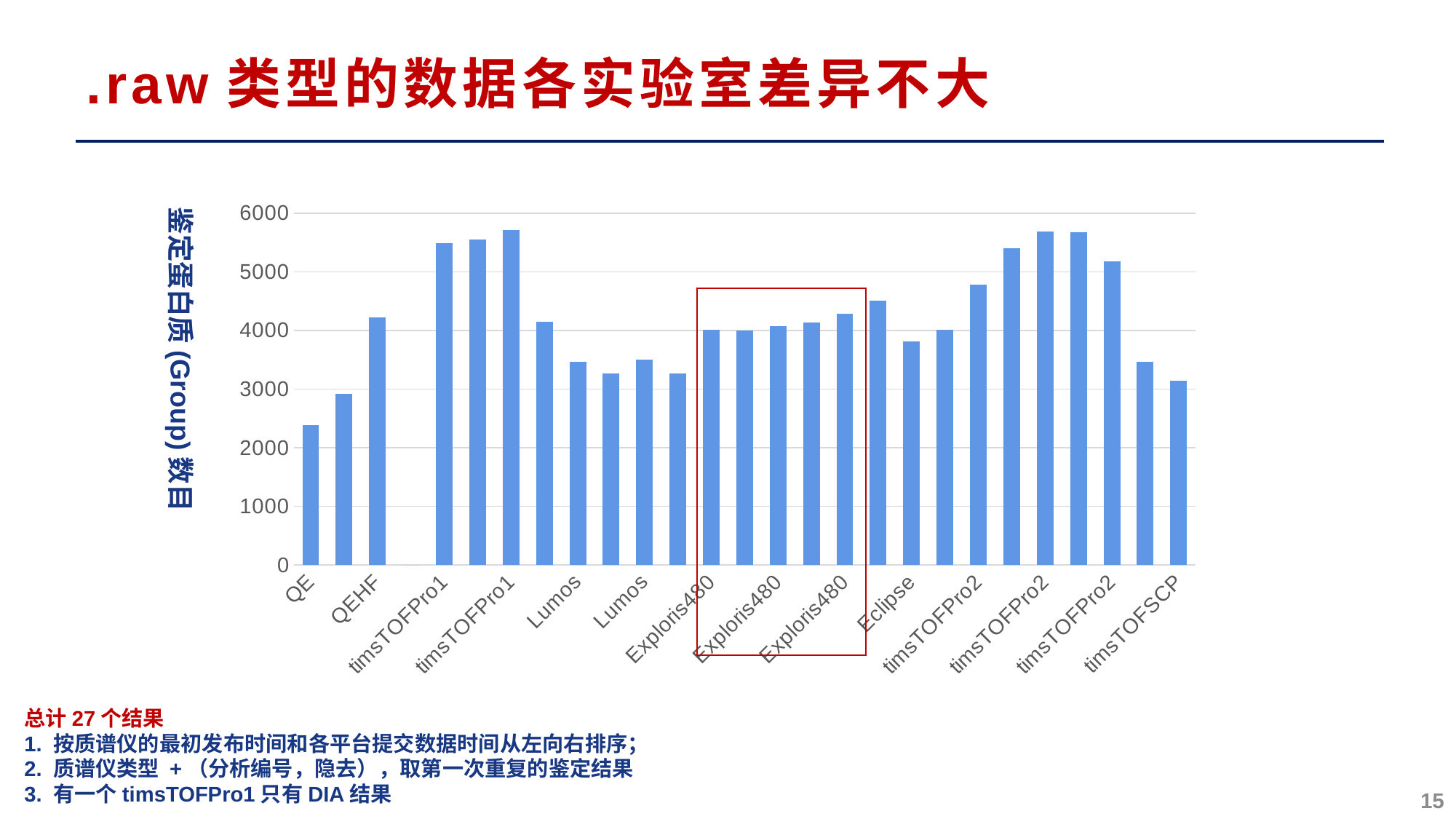
What kind of chart is shown on the slide? bar chart Is the value of the leftmost bar (QE) greater or less than 3000? less How many bars are enclosed by the red box in the chart? 5 Do the bars inside the red box rise or fall from left to right? rise Are the bars inside the red box greater or less than 5000? less Which is larger, the leftmost bar or the rightmost bar? the rightmost bar Which is larger, the first bar or the second bar from the left? the second bar Are the bars inside the red box greater or less than 3000? greater Which bar is the lowest in the chart? the leftmost bar (QE) What is the highest tick value shown on the vertical axis? 6000 What is the title of the vertical axis of the chart? 鉴定蛋白质(Group)数目